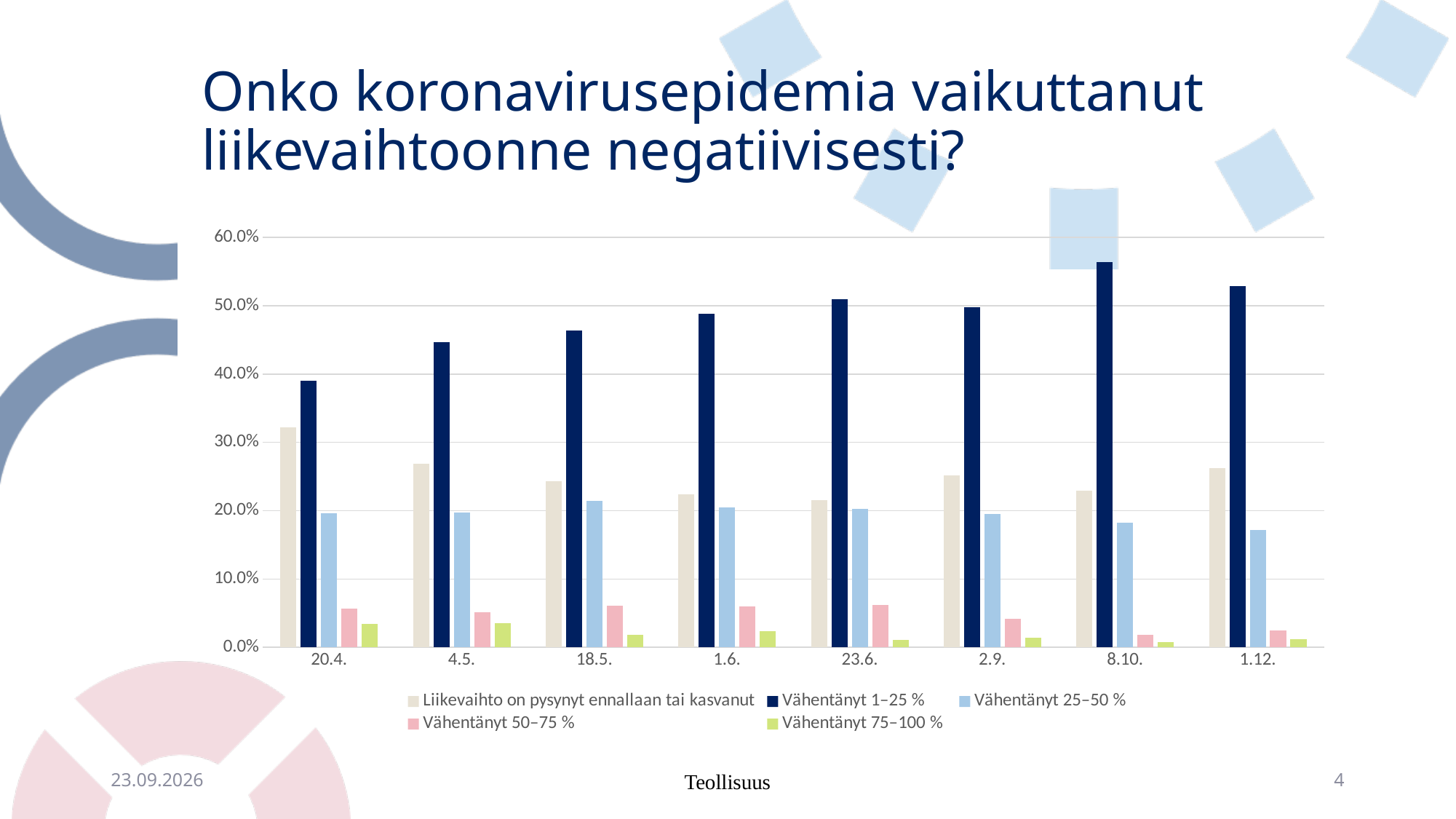
Is the value for 'Liikevaihto on pysynyt ennallaan tai kasvanut' at 20.4. greater or less than 30.0%? greater At which date is the value for 'Vähentänyt 1–25 %' highest? 8.10. At which date is the value for 'Vähentänyt 25–50 %' lowest? 1.12. At which date is the value for 'Liikevaihto on pysynyt ennallaan tai kasvanut' highest? 20.4. Does the value for 'Vähentänyt 1–25 %' rise or fall from 20.4. to 23.6.? rise At which date is the value for 'Vähentänyt 1–25 %' lowest? 20.4. What kind of chart is shown on the slide? bar chart Is the value for 'Vähentänyt 1–25 %' at 8.10. greater or less than 50.0%? greater Is the value for 'Vähentänyt 1–25 %' at 20.4. greater or less than 40.0%? less How many dates (categories) are shown on the x axis? 8 At 1.12., which is larger: 'Liikevaihto on pysynyt ennallaan tai kasvanut' or 'Vähentänyt 25–50 %'? Liikevaihto on pysynyt ennallaan tai kasvanut How many series does the legend list? 5